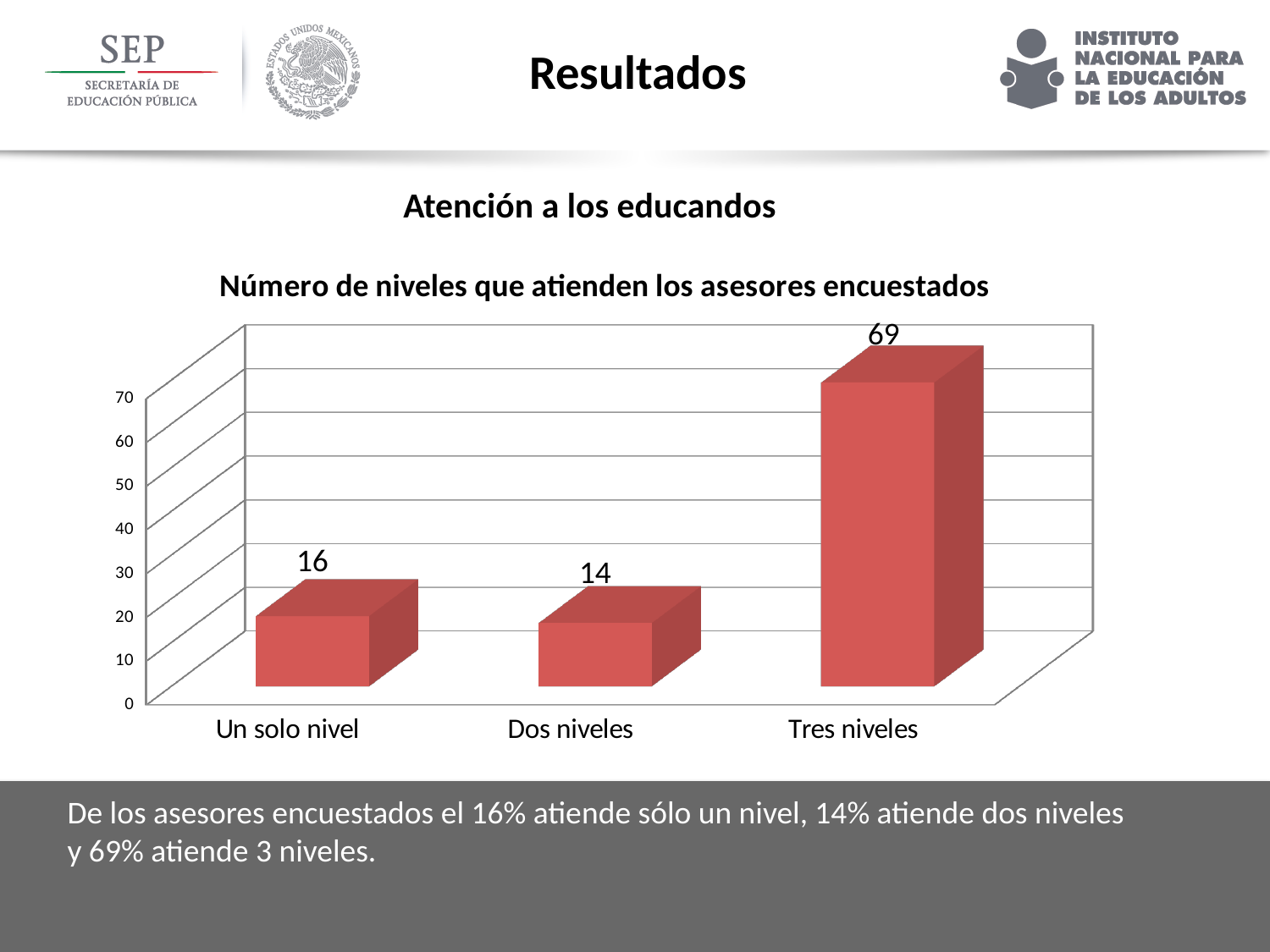
Is the value for "Tres niveles" greater or less than 60? greater What is the difference between the values for "Tres niveles" and "Un solo nivel"? 53 Which category has the lowest value? Dos niveles What is the value for "Un solo nivel"? 16 What kind of chart is shown on the slide? bar chart What is the difference between the values for "Un solo nivel" and "Dos niveles"? 2 Which category has the highest value? Tres niveles What is the title of the chart? Número de niveles que atienden los asesores encuestados What is the value for "Tres niveles"? 69 How many categories are shown on the x axis? 3 What is the value for "Dos niveles"? 14 Which is larger, the value for "Un solo nivel" or the value for "Tres niveles"? Tres niveles